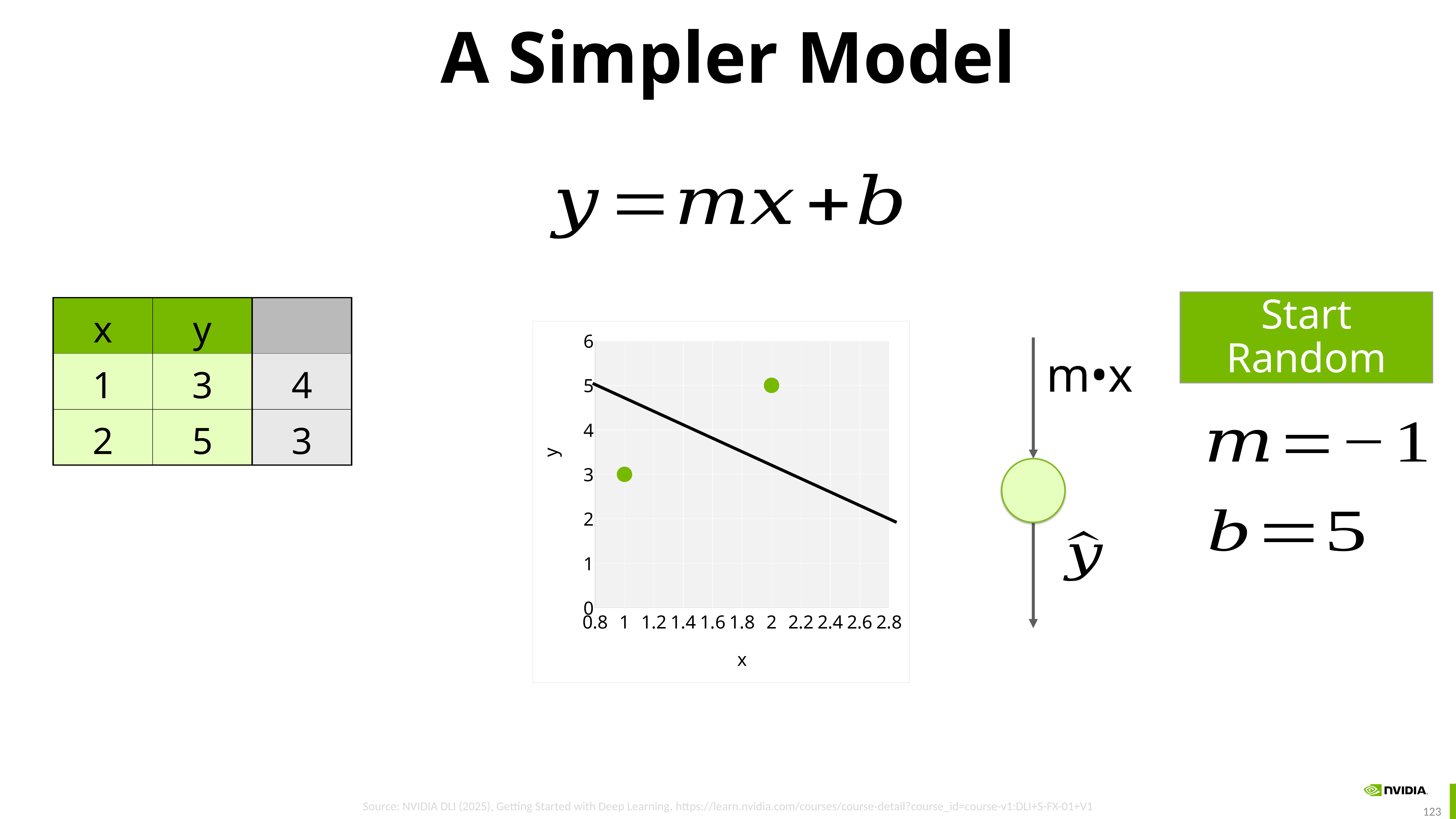
What is the difference in y between the point at x = 2 and the point at x = 1? 2 How many data points are plotted on the chart? 2 What is the maximum value shown on the y axis of the chart? 6 What is the y value of the plotted point at x = 1? 3 Which plotted point has the higher y value, the one at x = 1 or the one at x = 2? x = 2 What is the label on the vertical axis of the chart? y Does the black line on the chart rise or fall as x increases? fall Do the plotted points rise or fall as x increases? rise Is the y value of the point at x = 2 greater or less than 4? greater Is the y value of the point at x = 1 greater or less than 4? less What is the y value of the plotted point at x = 2? 5 What kind of chart is shown on the slide? scatter chart